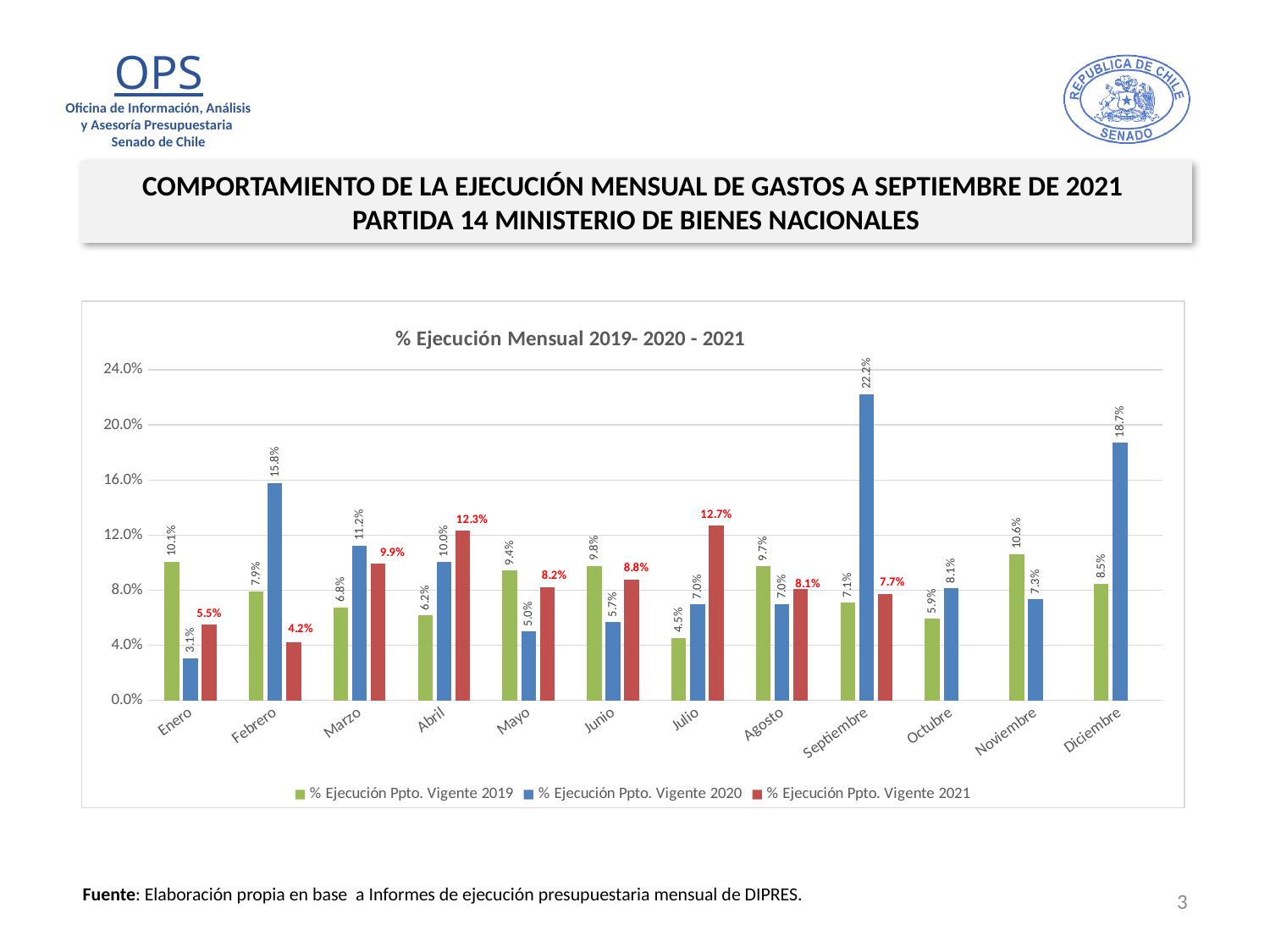
Which month has the lowest value for % Ejecución Ppto. Vigente 2021? Febrero How many months are shown on the x axis? 12 What is the value for % Ejecución Ppto. Vigente 2021 in Julio? 12.7% Which month has the highest value for % Ejecución Ppto. Vigente 2020? Septiembre What is the value for % Ejecución Ppto. Vigente 2020 in Septiembre? 22.2% Which month has the lowest value for % Ejecución Ppto. Vigente 2019? Julio Is the value for % Ejecución Ppto. Vigente 2020 in Febrero greater or less than 12.0%? greater What is the difference between the 2020 and 2019 values in Diciembre? 10.2% In Abril, which series has the larger value: % Ejecución Ppto. Vigente 2021 or % Ejecución Ppto. Vigente 2019? % Ejecución Ppto. Vigente 2021 What is the value for % Ejecución Ppto. Vigente 2019 in Noviembre? 10.6% What type of chart is shown on the slide? Bar chart How many series does the legend list? 3